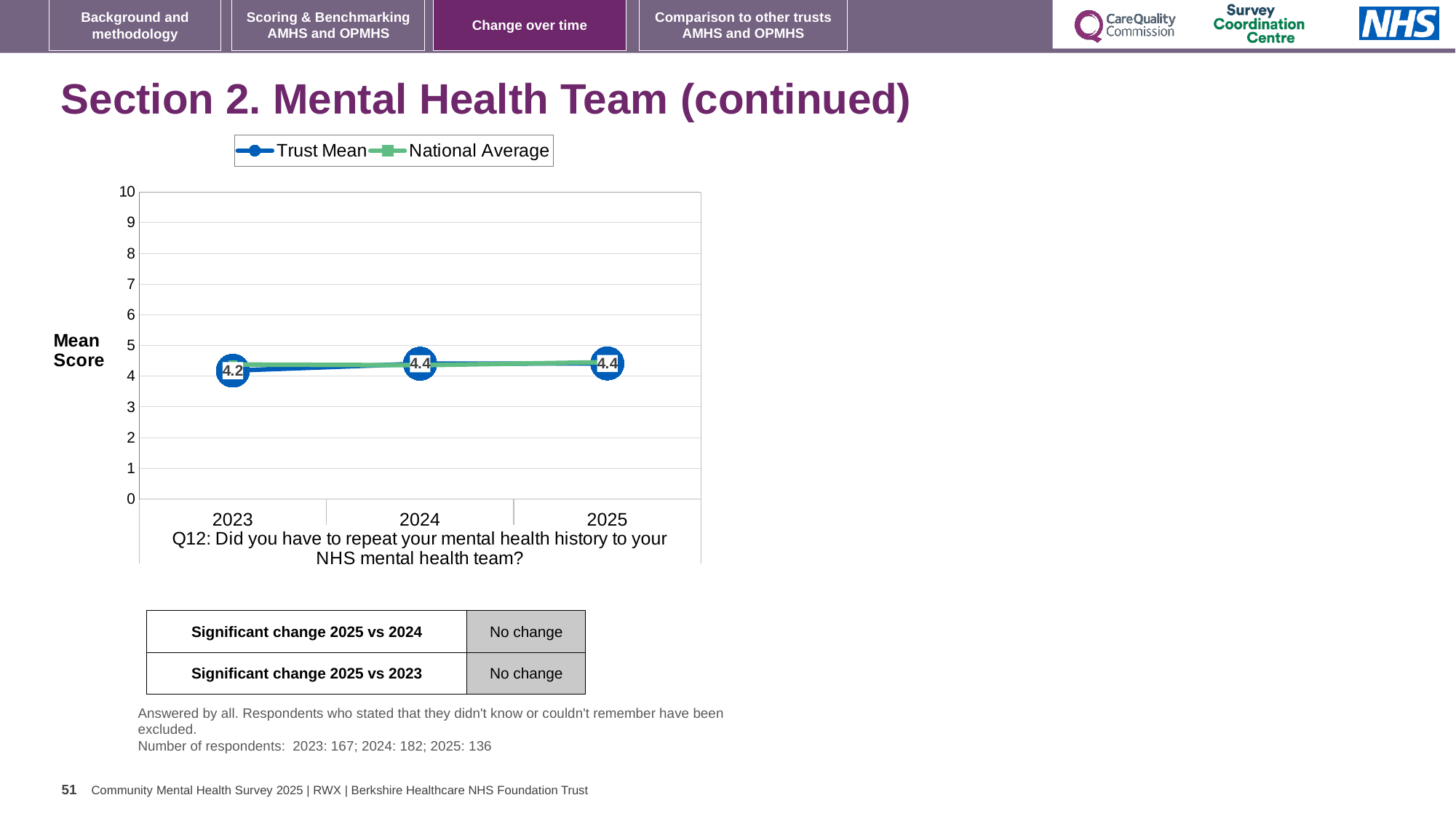
Does the Trust Mean score rise or fall from 2023 to 2024? Rise Is the National Average value for 2023 greater or less than 4? greater In which year is the Trust Mean score lowest? 2023 How many series does the legend list? 2 Is the National Average value for 2025 greater or less than 5? less What is the Trust Mean score for 2025? 4.4 Is the Trust Mean score for 2024 larger than the Trust Mean score for 2023? Yes What is the Trust Mean score for 2023? 4.2 What is the Trust Mean score for 2024? 4.4 What kind of chart is shown on the slide? Line chart What is the difference between the Trust Mean score in 2024 and in 2023? 0.2 How many years are plotted on the x axis? 3